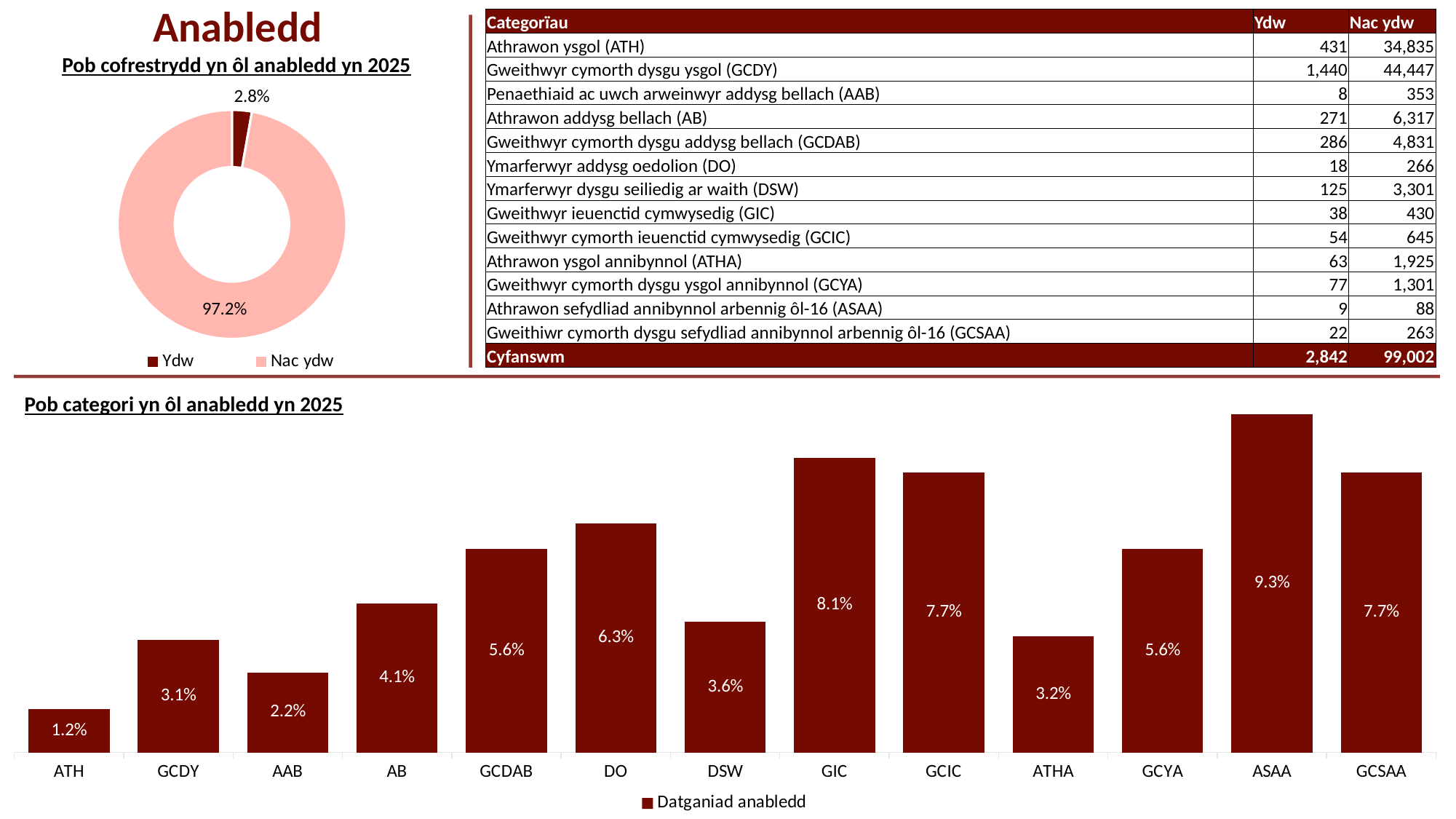
In the chart 'Pob categori yn ôl anabledd yn 2025', which category has the lowest value? ATH In the chart 'Pob categori yn ôl anabledd yn 2025', what is the value for DSW? 3.6% What kind of chart is 'Pob cofrestrydd yn ôl anabledd yn 2025'? Pie (doughnut) chart What kind of chart is 'Pob categori yn ôl anabledd yn 2025'? Bar chart How many entries does the legend of the chart 'Pob cofrestrydd yn ôl anabledd yn 2025' list? 2 In the chart 'Pob categori yn ôl anabledd yn 2025', what is the value for GIC? 8.1% In the chart 'Pob categori yn ôl anabledd yn 2025', what is the difference between the values for ASAA and ATH? 8.1% In the chart 'Pob categori yn ôl anabledd yn 2025', which category has the highest value? ASAA In the chart 'Pob categori yn ôl anabledd yn 2025', which is larger, the value for DO or the value for AB? DO How many categories are shown in the chart 'Pob categori yn ôl anabledd yn 2025'? 13 In the chart 'Pob cofrestrydd yn ôl anabledd yn 2025', what share of the pie is 'Nac ydw'? 97.2% In the chart 'Pob cofrestrydd yn ôl anabledd yn 2025', what share of the pie is 'Ydw'? 2.8%